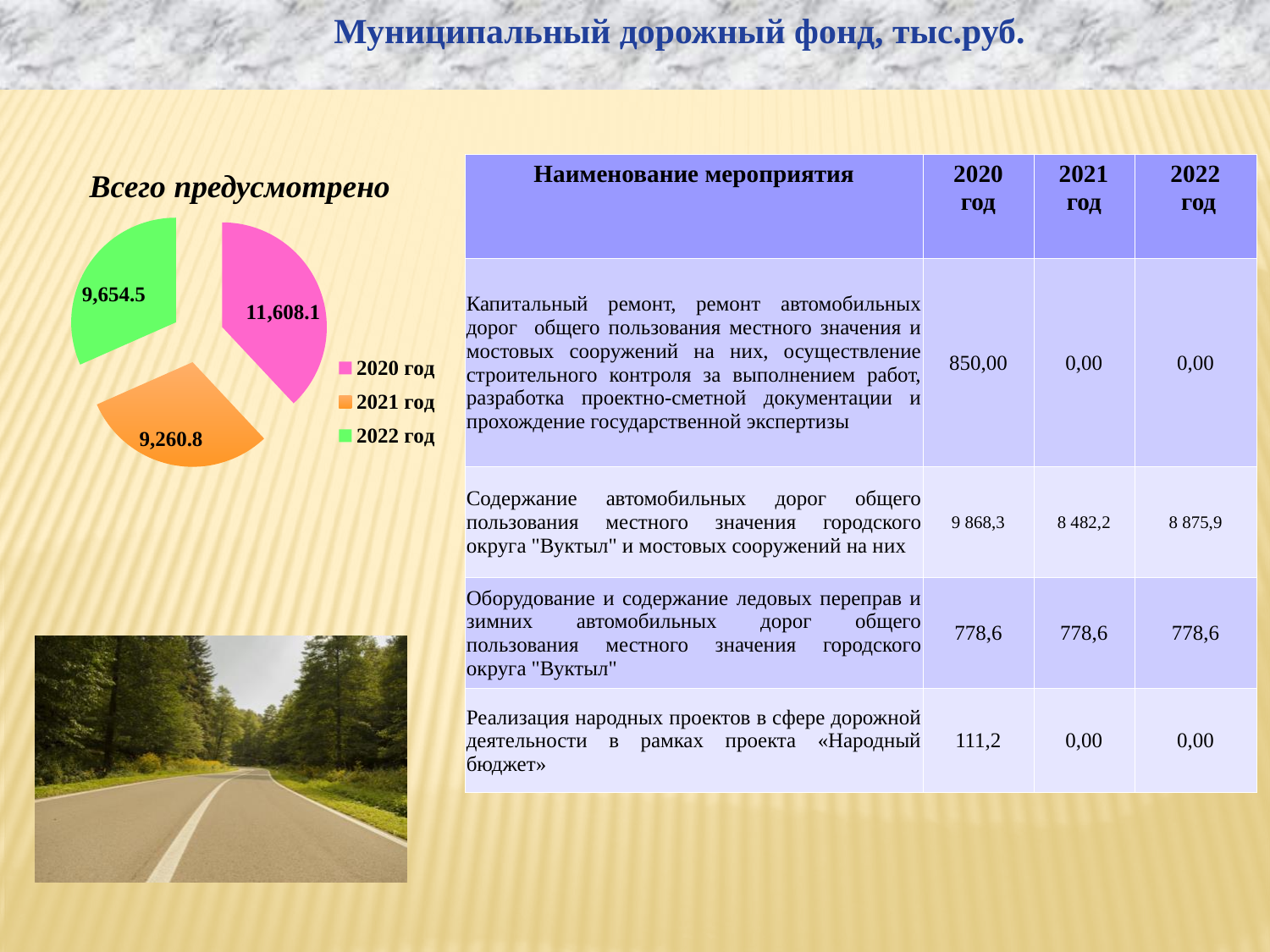
What is the difference between the values for 2022 год and 2021 год in the pie chart? 393.7 What is the difference between the values for 2020 год and 2021 год in the pie chart? 2,347.3 What type of chart is shown on the slide? Pie chart What is the value shown for 2022 год in the pie chart? 9,654.5 Which is larger in the pie chart, the value for 2021 год or for 2022 год? 2022 год Which year has the smallest slice in the pie chart? 2021 год What is the value shown for 2021 год in the pie chart? 9,260.8 How many slices does the pie chart have? 3 Which year has the largest slice in the pie chart? 2020 год What is the title of the pie chart? Всего предусмотрено What is the value shown for 2020 год in the pie chart? 11,608.1 How many entries does the pie chart's legend list? 3